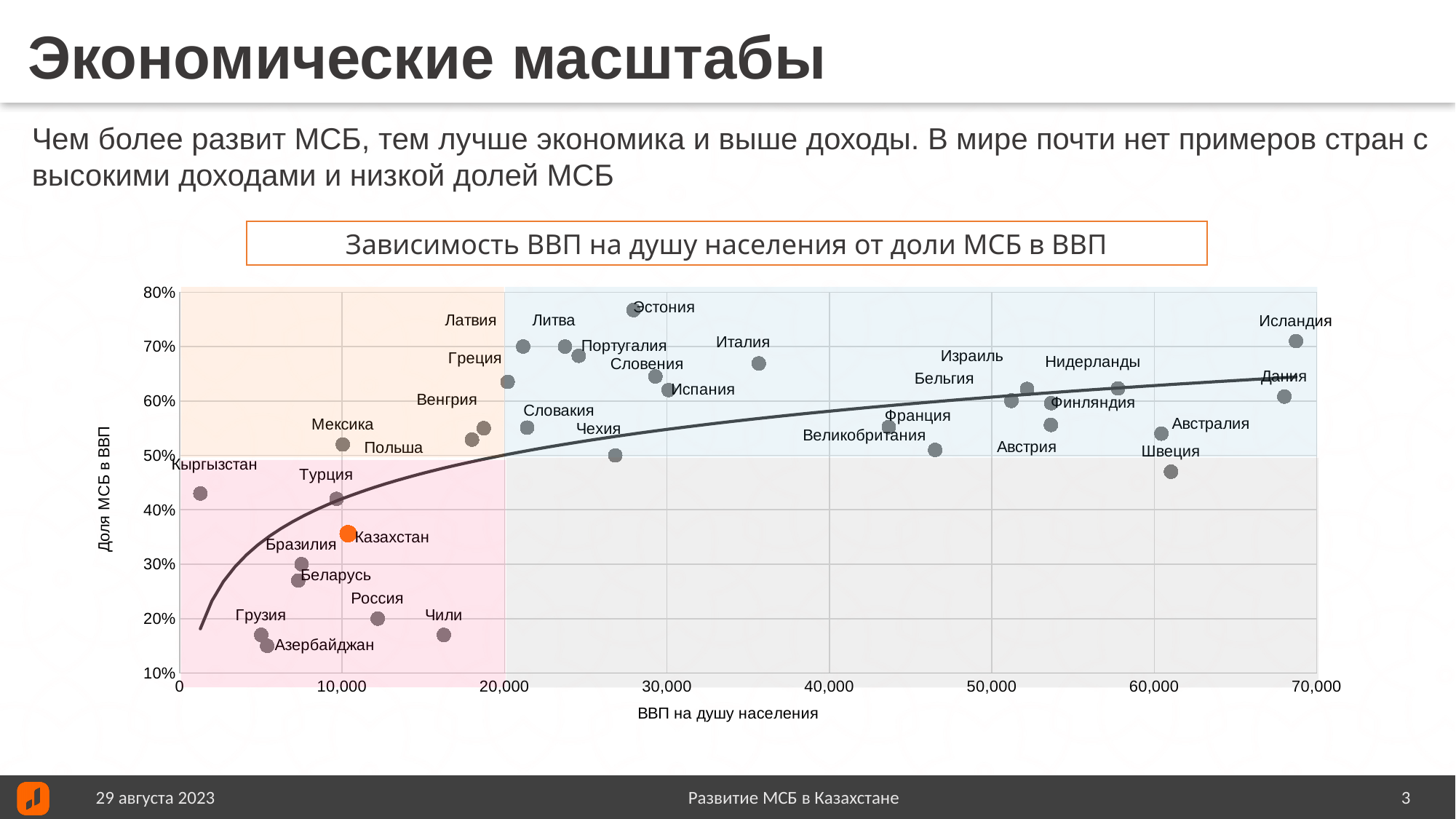
Is the share of SMEs in GDP for Казахстан greater or less than 40%? less What kind of chart is shown on the slide? Scatter chart Is the share of SMEs in GDP for Швеция greater or less than 50%? less Is the GDP per capita for Исландия greater or less than 60,000? greater Which has a higher share of SMEs in GDP, Словакия or Чехия? Словакия Which has a higher GDP per capita, Россия or Чили? Чили Which country has the lowest GDP per capita (ВВП на душу населения) on the chart? Кыргызстан Which country has the highest share of SMEs in GDP (Доля МСБ в ВВП) on the chart? Эстония What is the title of the chart? Зависимость ВВП на душу населения от доли МСБ в ВВП Which country's point is highlighted in orange on the chart? Казахстан